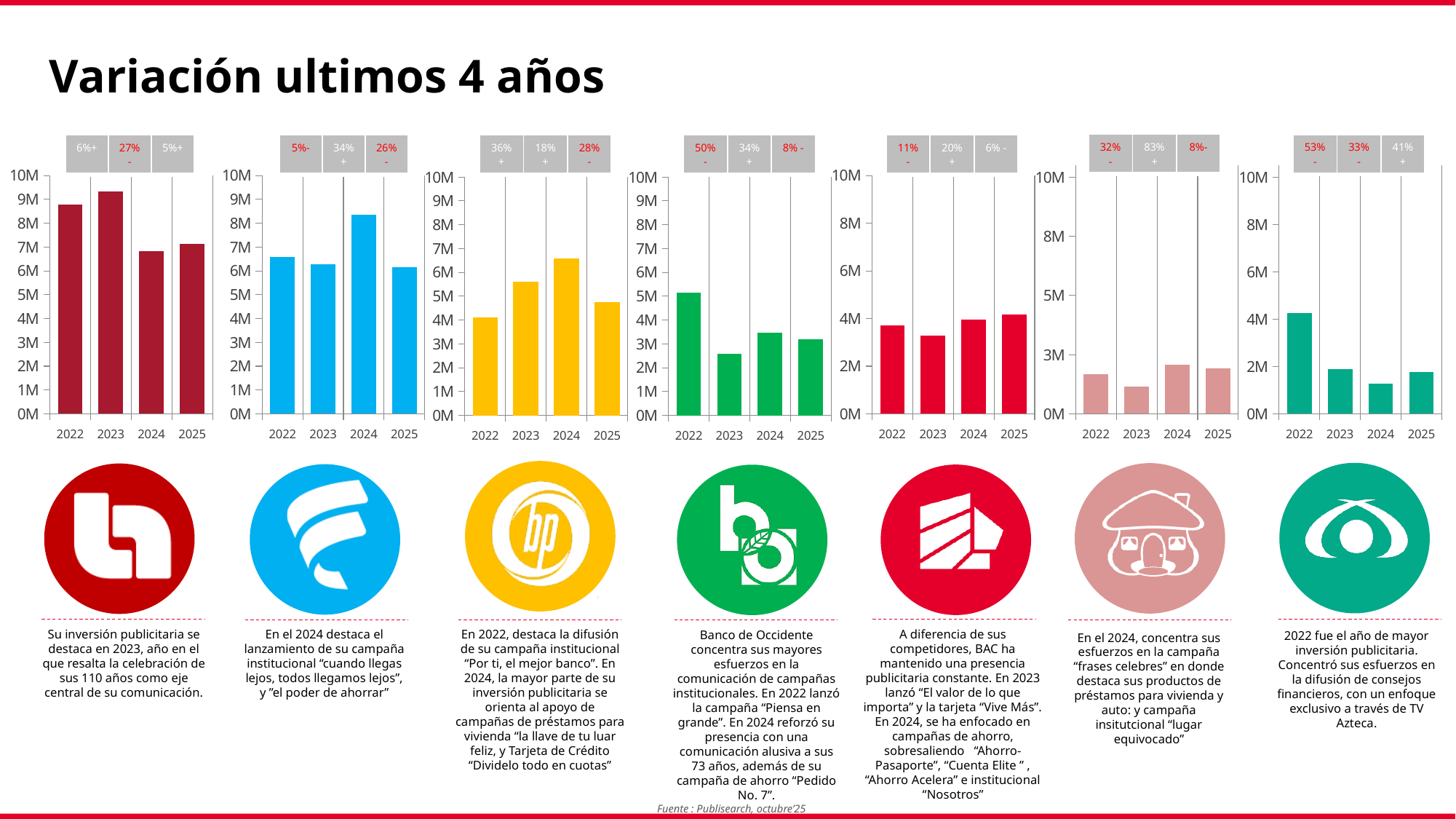
In the leftmost (dark red) chart, which year has the highest bar? 2023 In the rightmost chart (teal bars), which year has the highest value? 2022 In the leftmost (dark red) chart, which year has the lowest bar? 2024 In the sixth chart from the left (pink bars), is the value for 2023 greater or less than 2M? less How many bar charts are shown on the slide? 7 In the fourth chart from the left (green bars), which is larger, the value for 2022 or the value for 2023? 2022 In the second chart from the left (blue bars), which year has the highest value? 2024 In the rightmost chart (teal bars), do the values rise or fall from 2022 to 2024? fall What kind of chart is the leftmost chart on the slide? bar chart How many years (categories) does each chart show on its x axis? 4 In the fourth chart from the left (green bars), is the value for 2022 greater or less than 4M? greater In the third chart from the left (yellow bars), which year has the lowest value? 2022